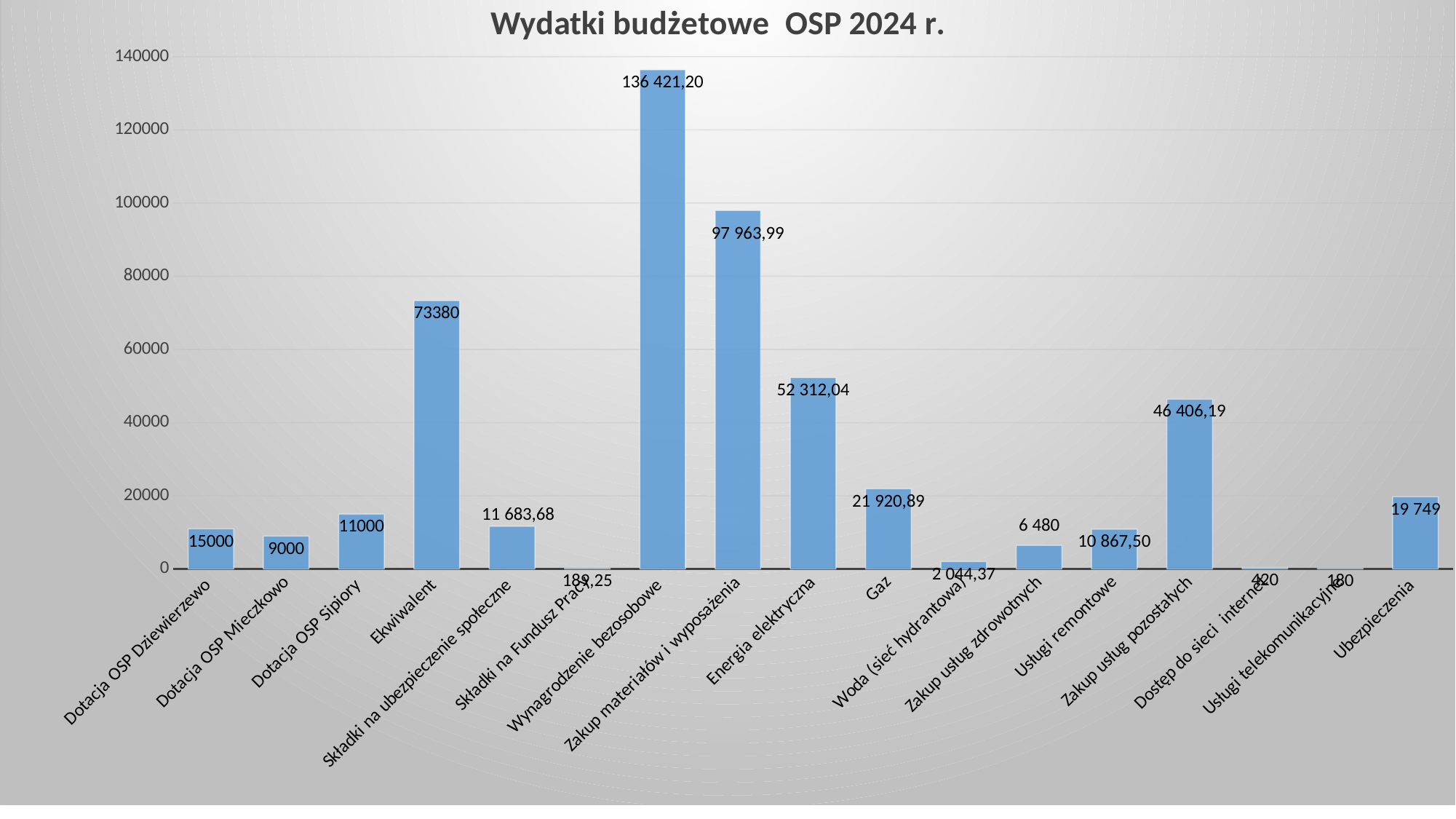
What is the title of the chart? Wydatki budżetowe OSP 2024 r. What is the value for Wynagrodzenie bezosobowe? 136 421,20 Which category has the highest value? Wynagrodzenie bezosobowe What is the difference between Wynagrodzenie bezosobowe and Zakup materiałów i wyposażenia? 38 457,21 How many categories are shown on the x axis? 17 What kind of chart is this? bar chart What is the value for Ekwiwalent? 73380 Which is larger, Energia elektryczna or Gaz? Energia elektryczna What is the value for Zakup usług pozostałych? 46 406,19 Is the value for Zakup materiałów i wyposażenia greater or less than 100000? less What is the value for Ubezpieczenia? 19 749